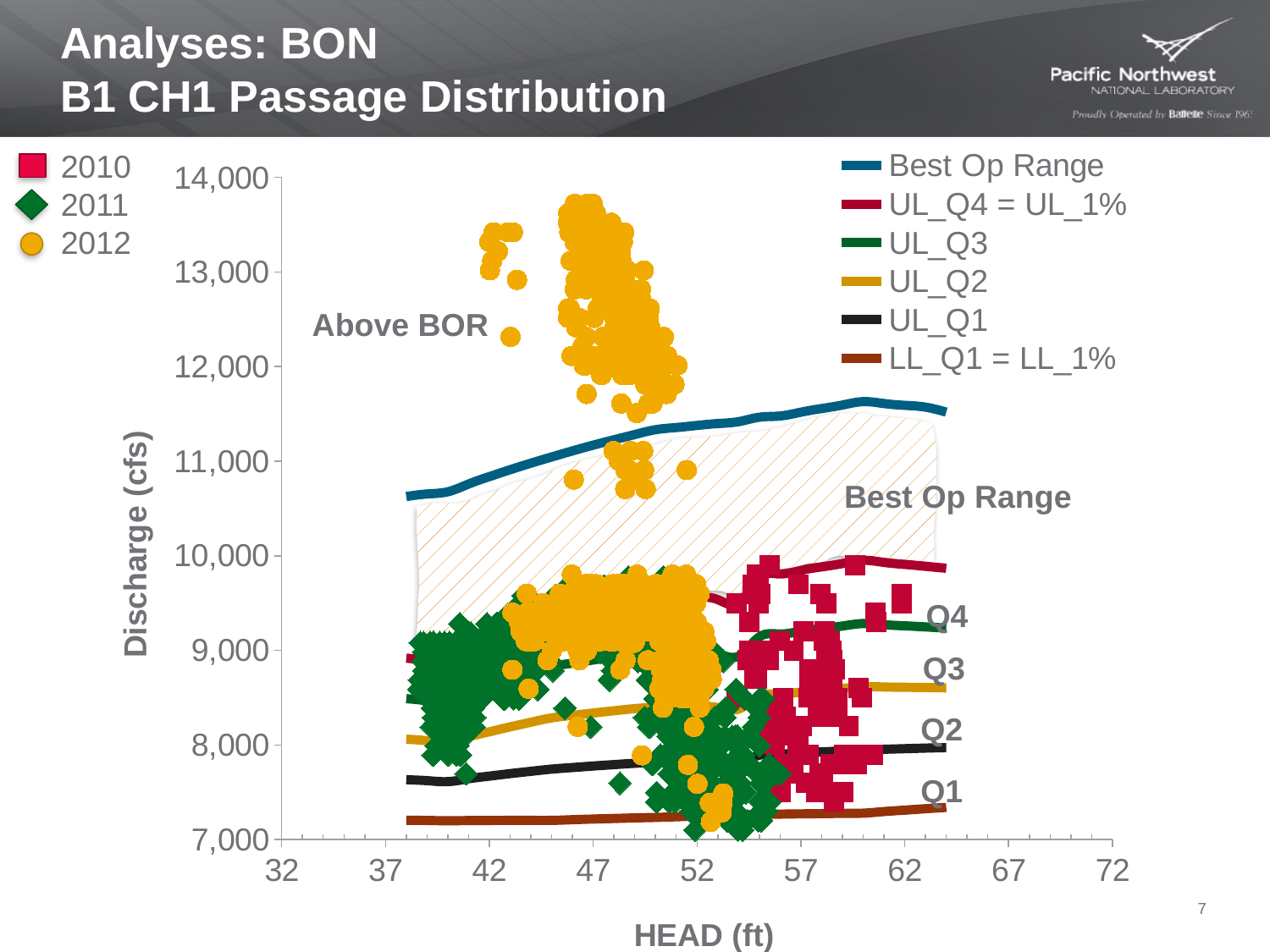
How many line series does the right-hand legend list? 6 What is the label of the y axis? Discharge (cfs) Which line series is the lowest on the chart across the plotted head range? LL_Q1 = LL_1% What kind of chart is shown on the slide? scatter plot Does the Best Op Range line rise or fall as head increases from 37 ft to 62 ft? rise What is the label of the x axis? HEAD (ft) Which line is higher at a head of 57 ft, Best Op Range or UL_Q4 = UL_1%? Best Op Range Is the value of the UL_Q1 line at a head of 37 ft greater or less than 8,000? less Is the value of the Best Op Range line at a head of 62 ft greater or less than 11,000? greater Is the value of the LL_Q1 = LL_1% line at a head of 47 ft greater or less than 8,000? less Which year's data points are plotted above 12,000 cfs? 2012 How many years are listed in the marker legend at the top left? 3